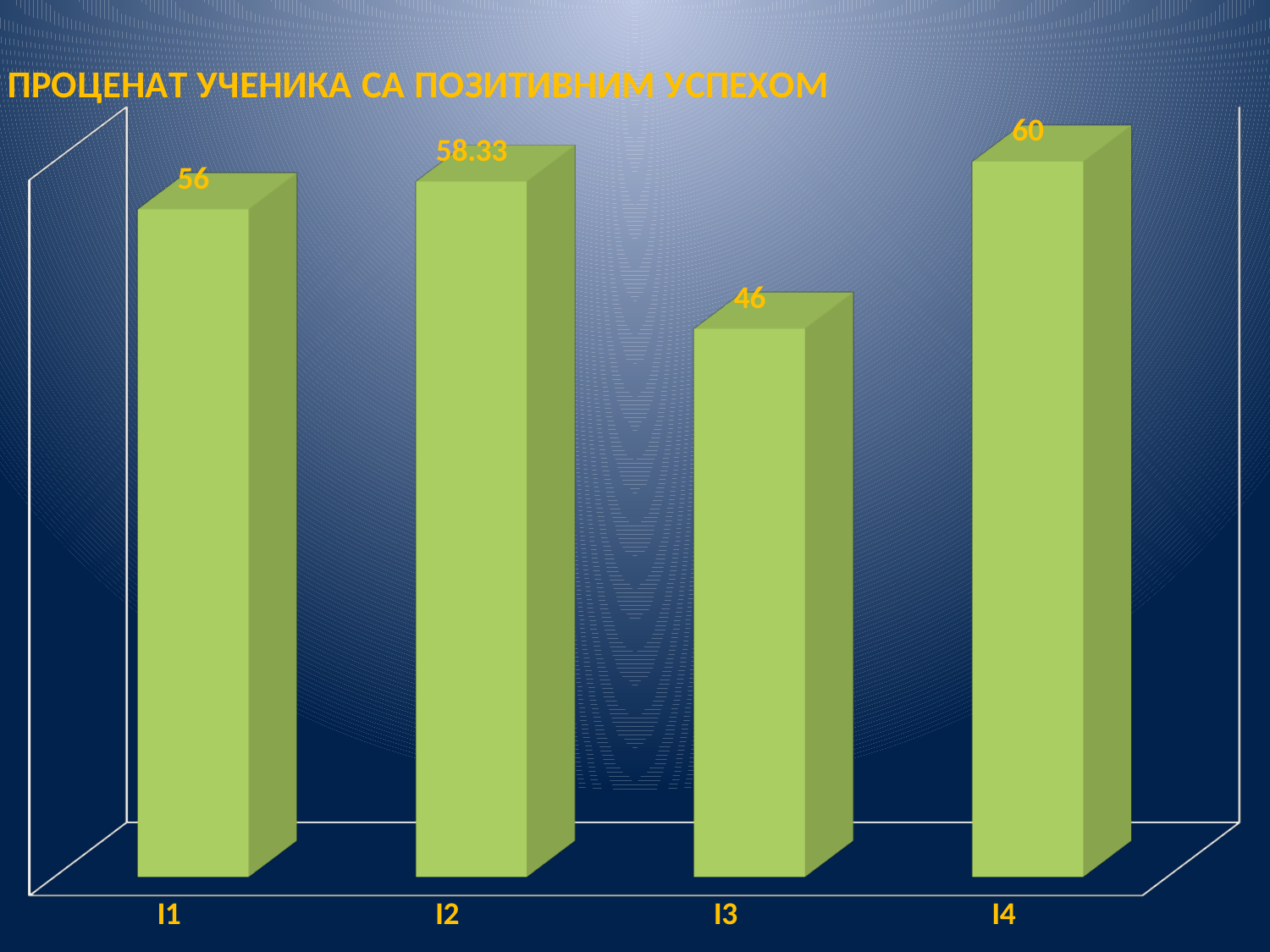
What kind of chart is shown on the slide? Bar chart What is the difference between the values for I4 and I3? 14 Which is larger, the value for I1 or the value for I3? I1 What is the value for I4? 60 What is the value for I1? 56 What is the value for I3? 46 Which category has the lowest value? I3 What is the difference between the values for I2 and I1? 2.33 How many categories are shown on the chart? 4 Which category has the highest value? I4 What is the value for I2? 58.33 What is the title of the chart? ПРОЦЕНАТ УЧЕНИКА СА ПОЗИТИВНИМ УСПЕХОМ